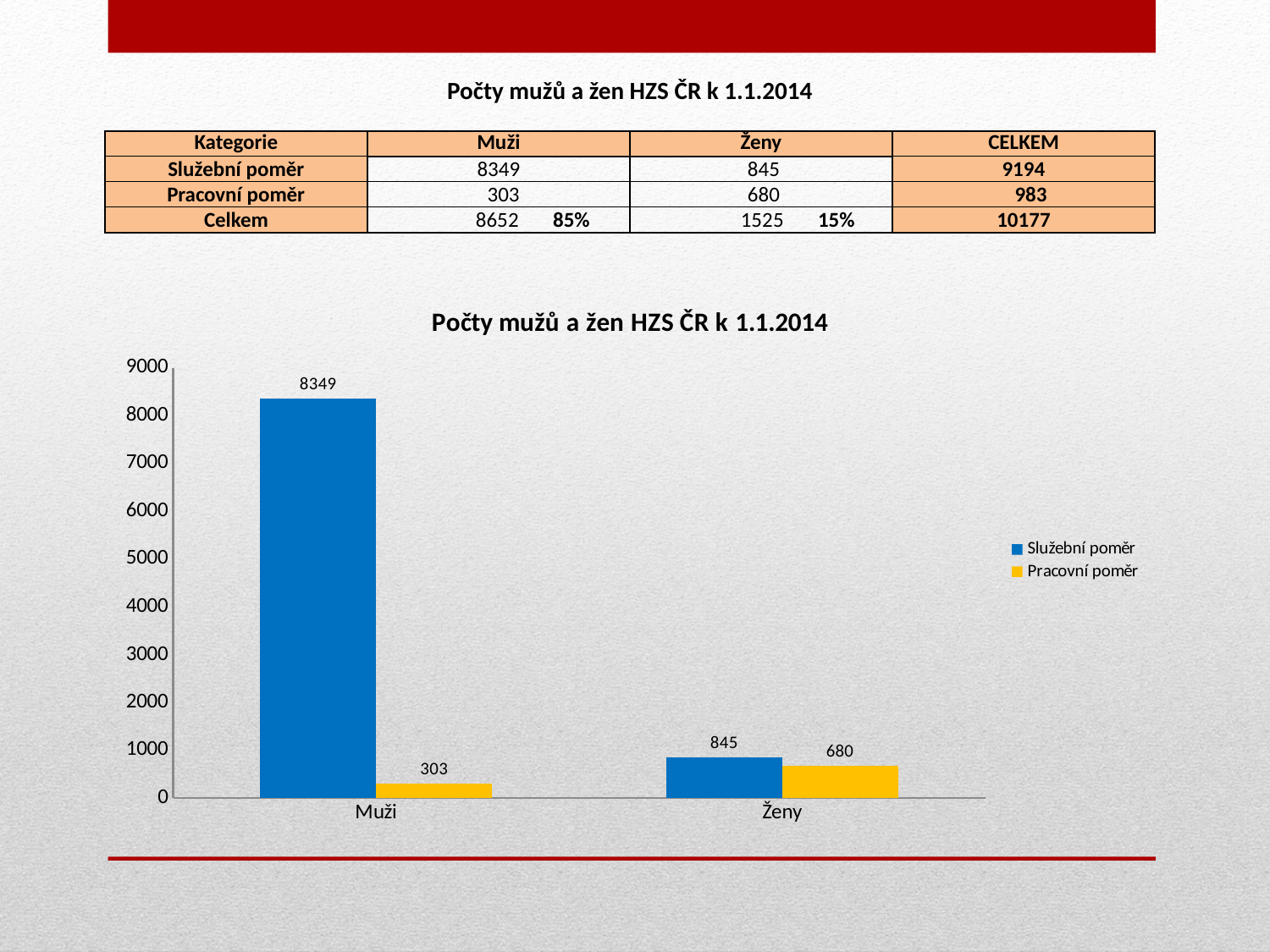
How many series does the legend list? 2 What is the value for Pracovní poměr in the Muži category? 303 What kind of chart is shown on the slide? bar chart Which category has the highest Služební poměr value? Muži What is the difference between the Služební poměr values for Muži and Ženy? 7504 How many categories are shown on the x axis? 2 What is the value for Pracovní poměr in the Ženy category? 680 Which category has the lowest Pracovní poměr value? Muži Which is larger: Služební poměr for Ženy or Pracovní poměr for Ženy? Služební poměr for Ženy Is the value for Služební poměr in the Muži category greater or less than 8000? greater What is the value for Služební poměr in the Ženy category? 845 What is the value for Služební poměr in the Muži category? 8349